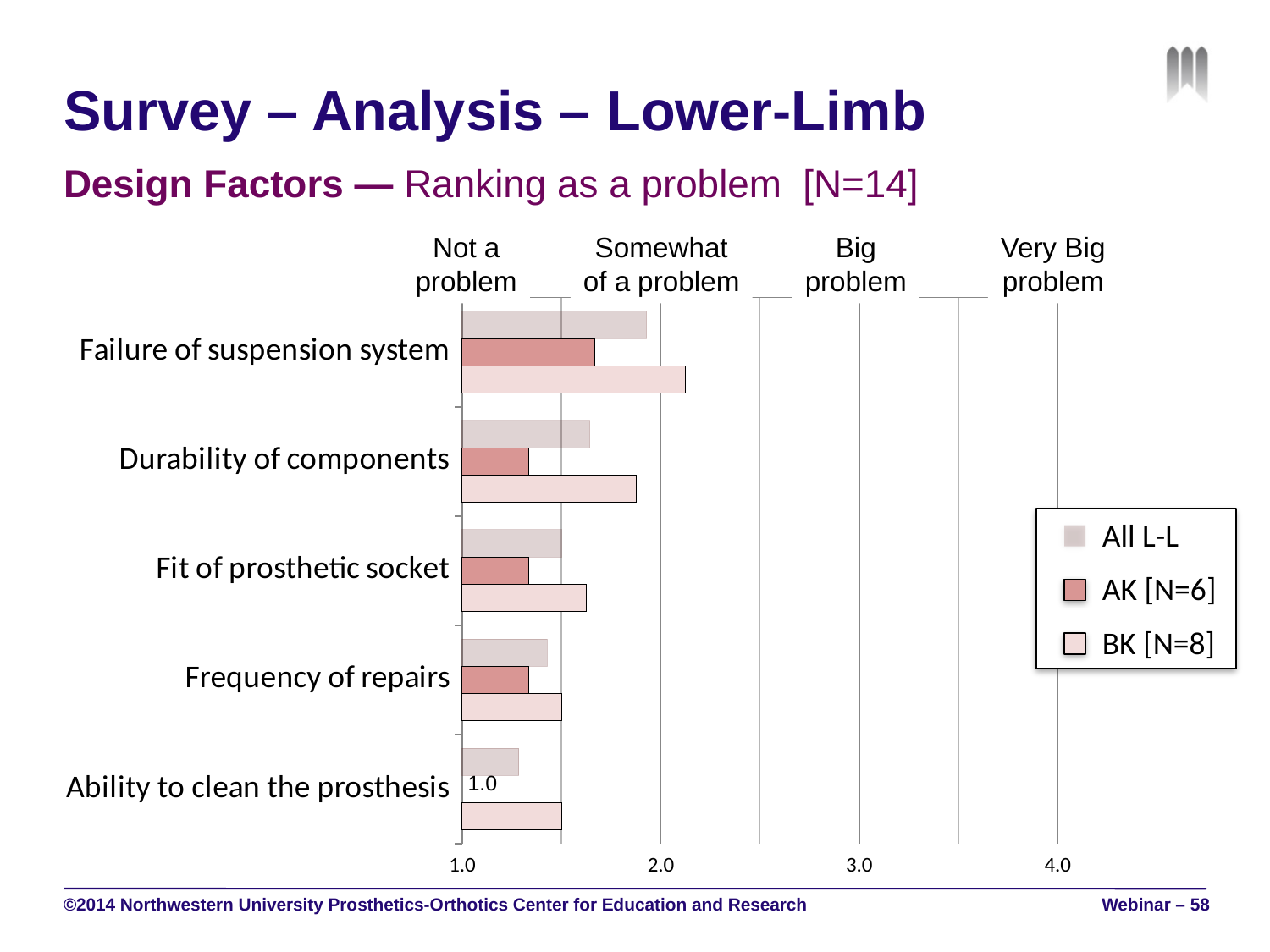
Which category has the highest BK [N=8] value? Failure of suspension system For Failure of suspension system, which series has the larger value, AK [N=6] or BK [N=8]? BK [N=8] How many series does the legend list? 3 Which category has the highest All L-L value? Failure of suspension system What kind of chart is shown on the slide? bar chart Is the BK [N=8] value for Durability of components greater or less than 2.0? less Which category has the lowest AK [N=6] value? Ability to clean the prosthesis What are the three series listed in the legend? All L-L, AK [N=6], BK [N=8] How many design factor categories are plotted on the chart? 5 Is the All L-L value for Failure of suspension system greater or less than 2.0? less Is the BK [N=8] value for Failure of suspension system greater or less than 2.0? greater What is the AK [N=6] value for Ability to clean the prosthesis? 1.0